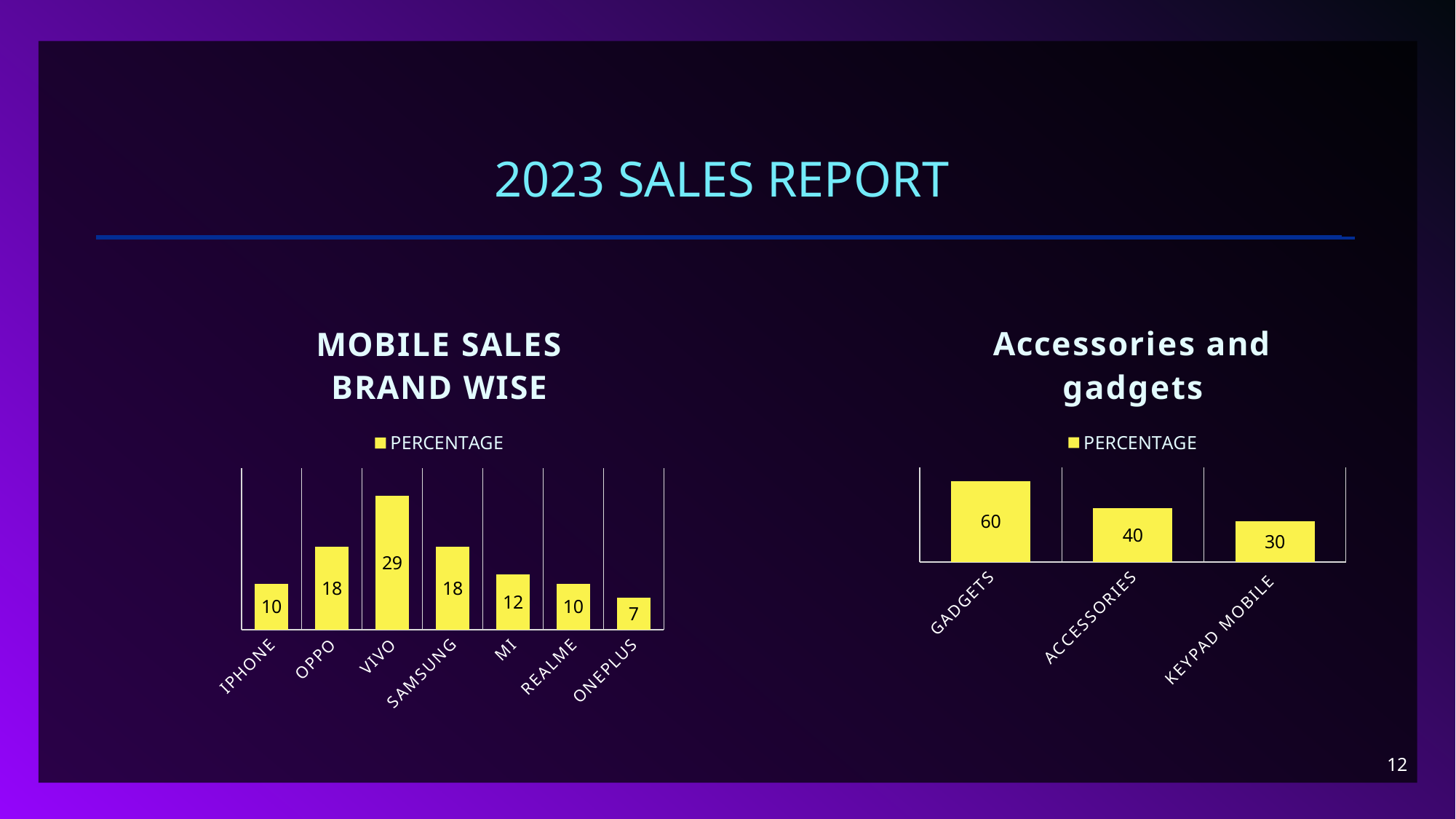
How many series does the legend of the MOBILE SALES BRAND WISE chart list? 1 What kind of chart is the Accessories and gadgets chart? Bar chart In the MOBILE SALES BRAND WISE chart, which is larger, the value for SAMSUNG or the value for REALME? SAMSUNG In the Accessories and gadgets chart, what is the difference between the values for GADGETS and KEYPAD MOBILE? 30 How many brands are shown in the MOBILE SALES BRAND WISE chart? 7 In the MOBILE SALES BRAND WISE chart, what is the value for MI? 12 In the MOBILE SALES BRAND WISE chart, which brand has the highest value? VIVO In the Accessories and gadgets chart, what is the value for ACCESSORIES? 40 In the MOBILE SALES BRAND WISE chart, what is the value for VIVO? 29 In the MOBILE SALES BRAND WISE chart, which brand has the lowest value? ONEPLUS In the Accessories and gadgets chart, which category has the highest value? GADGETS In the MOBILE SALES BRAND WISE chart, what is the difference between the values for VIVO and OPPO? 11